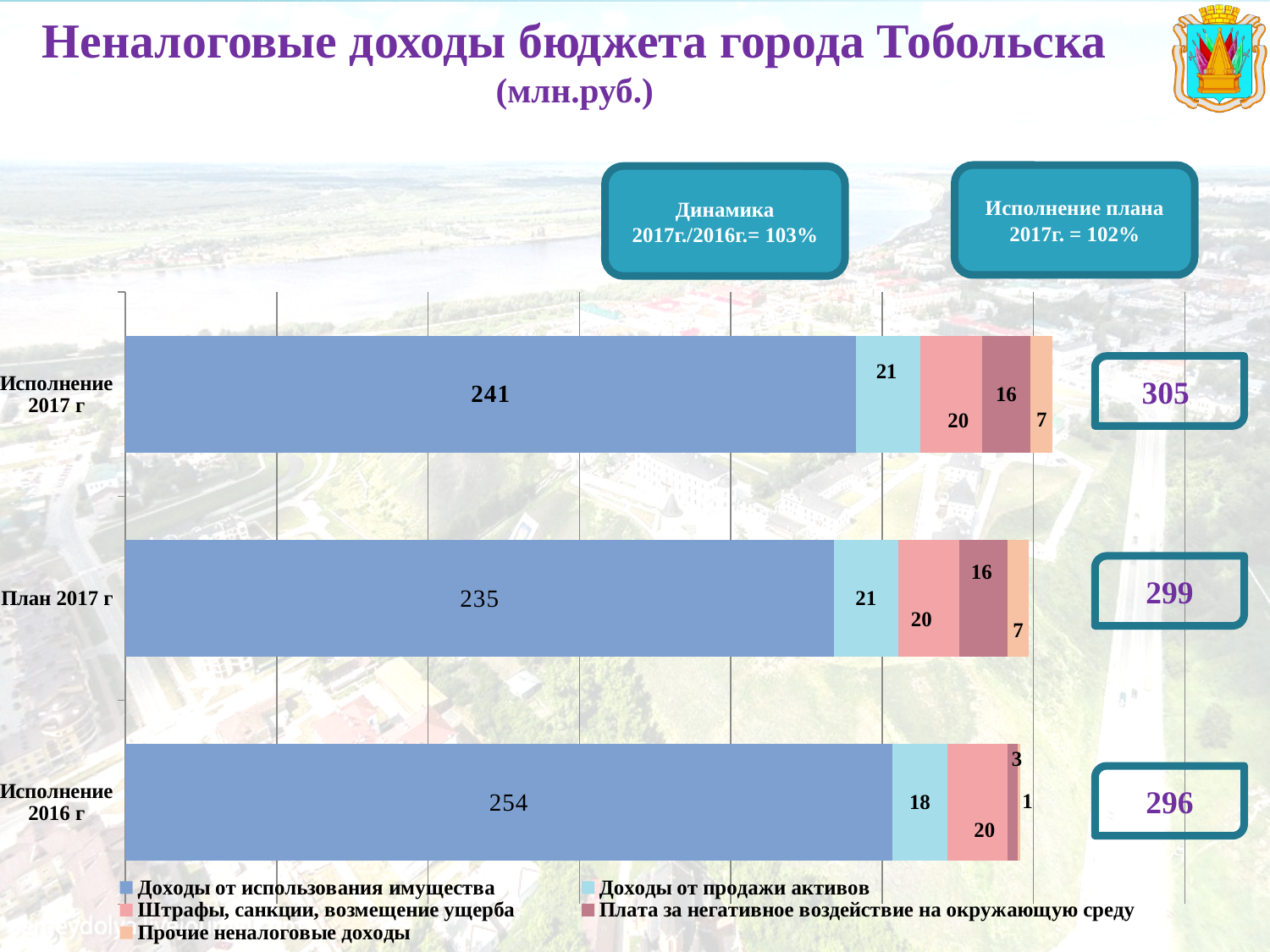
What is the total shown for the 'Исполнение 2016 г' bar? 296 Which is larger: 'Прочие неналоговые доходы' for 'Исполнение 2017 г' or for 'Исполнение 2016 г'? Исполнение 2017 г What is the value of 'Плата за негативное воздействие на окружающую среду' for 'Исполнение 2016 г'? 3 What is the value of 'Доходы от использования имущества' for 'План 2017 г'? 235 What type of chart is shown on the slide? Stacked bar chart How many series does the legend list? 5 How many categories (bars) are shown in the chart? 3 What is the value of 'Доходы от продажи активов' for 'Исполнение 2016 г'? 18 Which category has the highest value for 'Доходы от использования имущества'? Исполнение 2016 г What is the value of 'Доходы от использования имущества' for 'Исполнение 2017 г'? 241 What is the total shown for the 'Исполнение 2017 г' bar? 305 What is the difference between 'Доходы от использования имущества' for 'Исполнение 2017 г' and 'План 2017 г'? 6